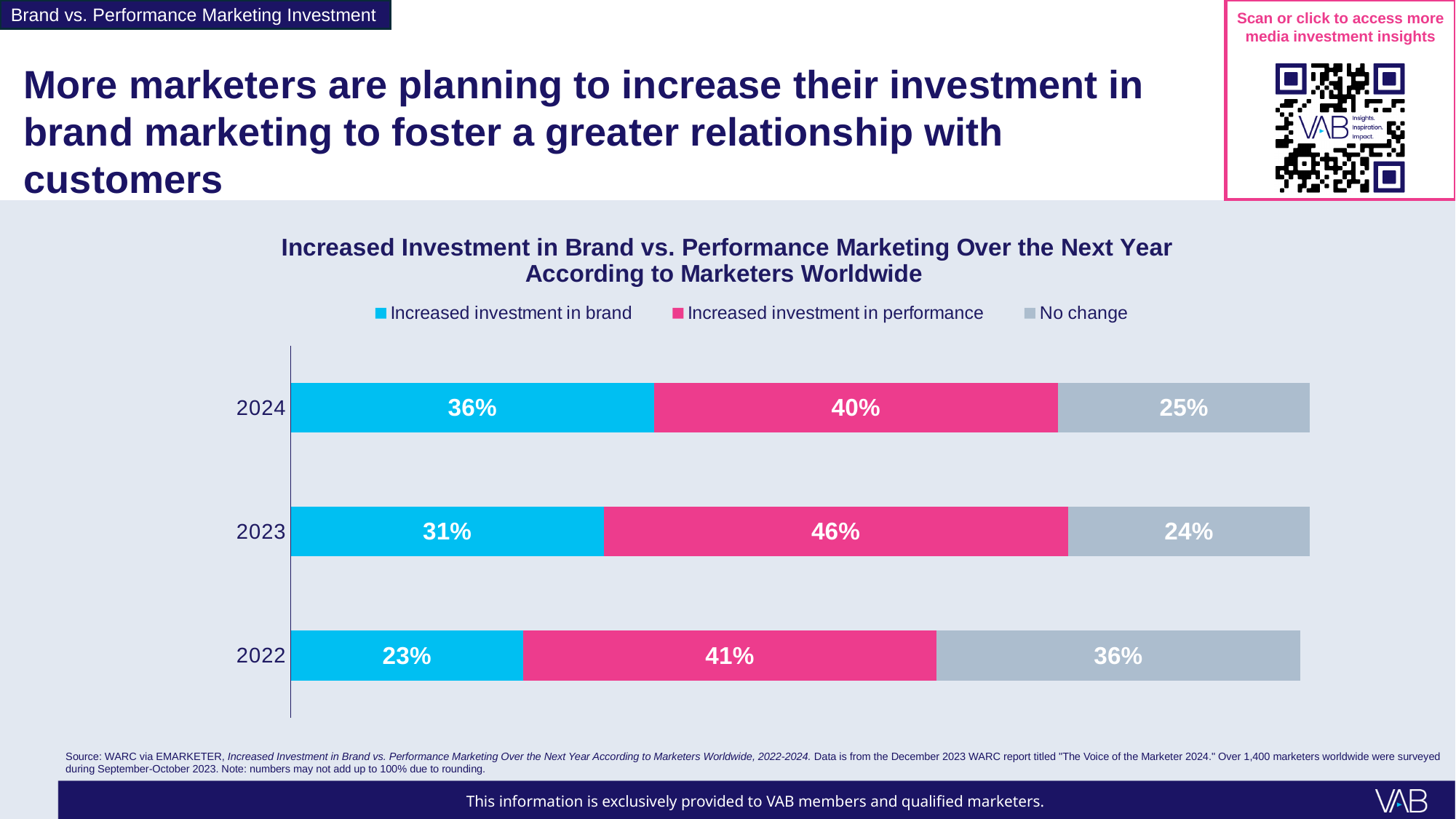
What is the 'No change' value for 2022? 36% How many series does the legend list? 3 In which year was the 'Increased investment in brand' value highest? 2024 What percentage of marketers reported increased investment in brand in 2024? 36% Does the 'Increased investment in brand' value rise or fall from 2022 to 2024? Rise What is the difference between the 'Increased investment in brand' values for 2024 and 2022? 13 percentage points How many years are shown on the chart? 3 What kind of chart is shown on the slide? Stacked bar chart What colour represents 'No change' in the chart? Grey What percentage of marketers reported increased investment in performance in 2023? 46% In which year was the 'Increased investment in brand' value lowest? 2022 Which is larger in 2024: 'Increased investment in brand' or 'Increased investment in performance'? Increased investment in performance